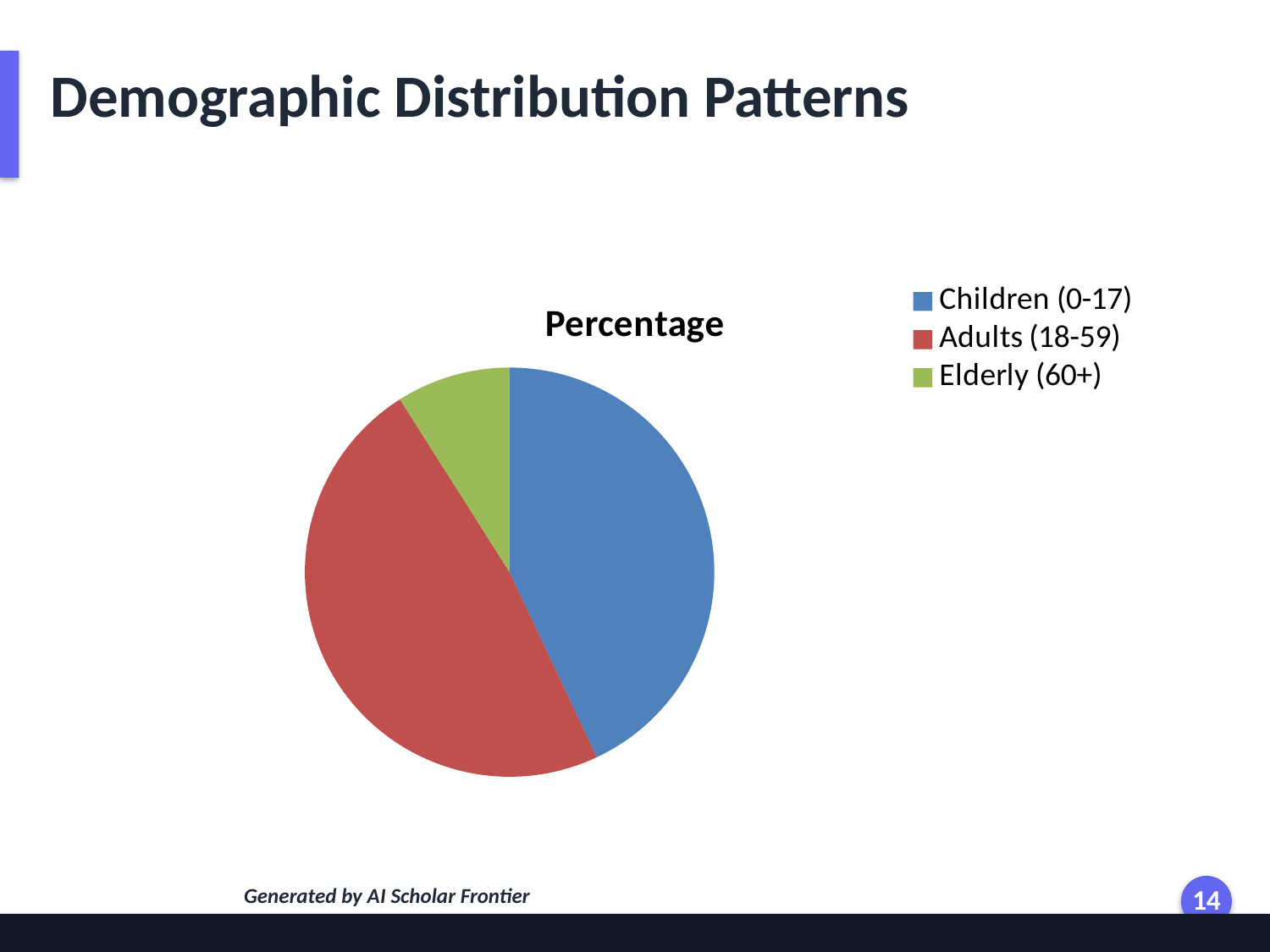
What colour is the Adults (18-59) slice in the pie chart? red What is the title of the pie chart? Percentage What kind of chart is shown on the slide? pie chart How many categories does the pie chart show? 3 Which category has the smallest slice in the pie chart? Elderly (60+) How many entries does the legend of the pie chart list? 3 Which slice is larger, Adults (18-59) or Elderly (60+)? Adults (18-59) Which slice is larger, Children (0-17) or Elderly (60+)? Children (0-17)